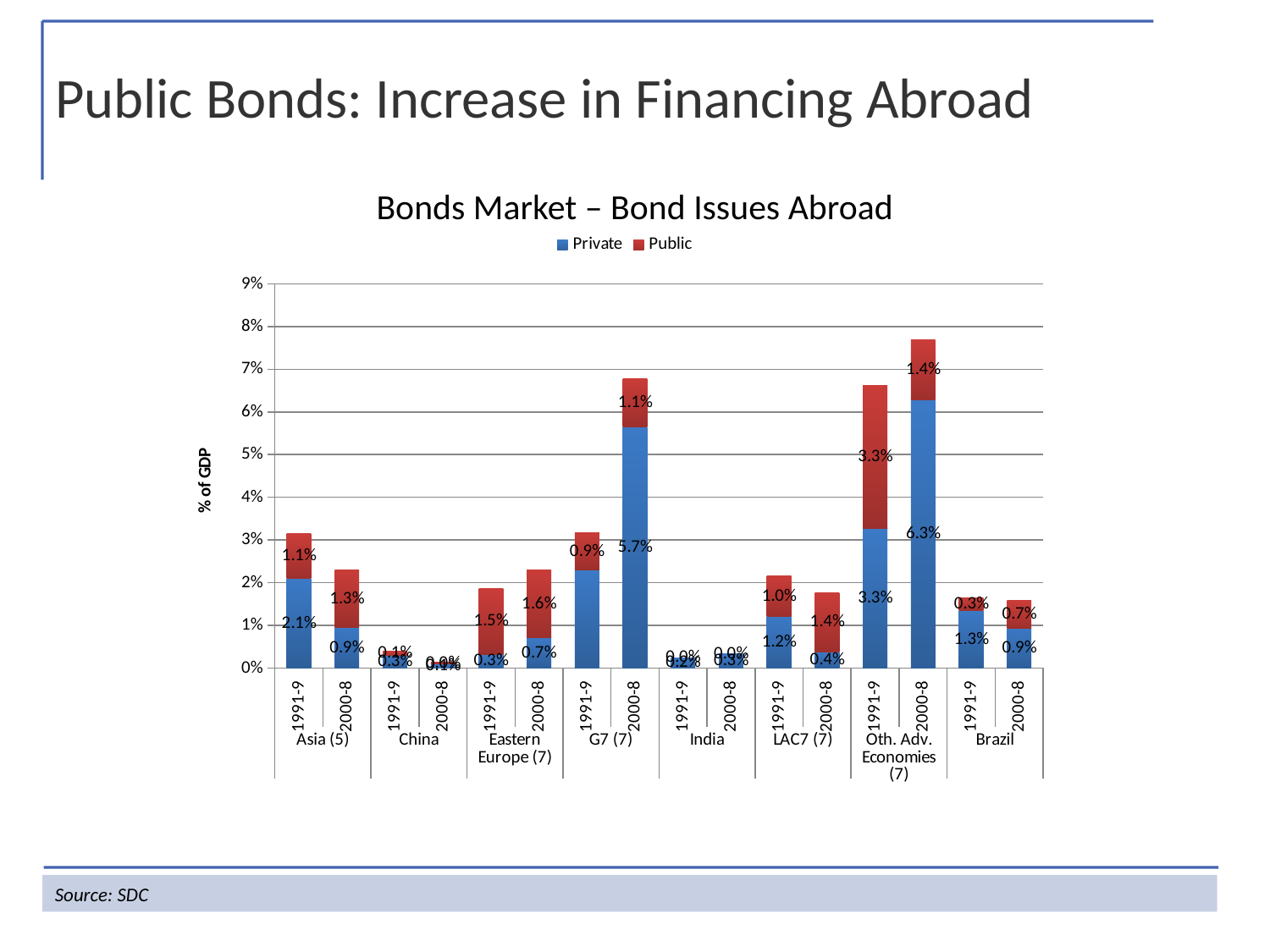
What is the Private value for Asia (5) in 1991-9? 2.1% Is the Private value for G7 (7) in 2000-8 larger than the Private value for Asia (5) in 1991-9? Yes What is the total of the stacked bar for Oth. Adv. Economies (7) in 1991-9? 6.6% What is the difference between the Private values for Oth. Adv. Economies (7) in 2000-8 and 1991-9? 3.0% How many series does the legend list? 2 What is the total of the stacked bar for Brazil in 2000-8? 1.6% What type of chart is shown? Stacked bar chart What is the Public value for Eastern Europe (7) in 2000-8? 1.6% What is the Private value for Oth. Adv. Economies (7) in 2000-8? 6.3% Which group and period has the tallest stacked bar? Oth. Adv. Economies (7), 2000-8 Is the total stacked bar for G7 (7) in 2000-8 greater or less than 6%? greater What is the Public value for LAC7 (7) in 2000-8? 1.4%